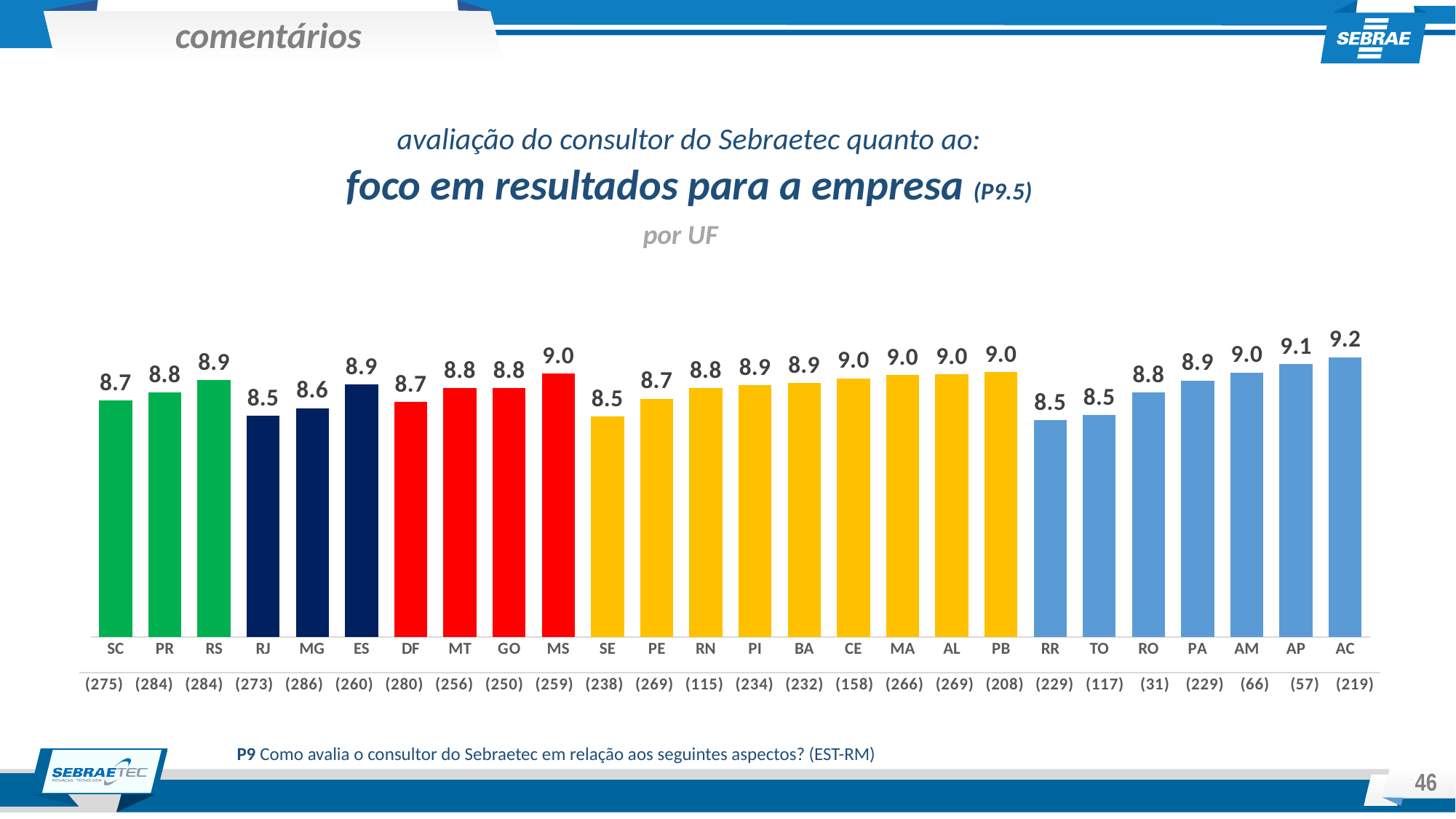
What kind of chart is shown on the slide? bar chart How many UFs are shown on the chart? 26 Which is larger, the value for AP or the value for MG? AP What is the value for MG? 8.6 What is the lowest value shown on the chart? 8.5 What is the value for SE? 8.5 What is the number shown in parentheses below RO? (31) What is the difference between the values for MS and SE? 0.5 What is the difference between the values for AC and RJ? 0.7 Which UF has the highest value? AC What colour are the bars for SC, PR and RS? green What is the value for AC? 9.2